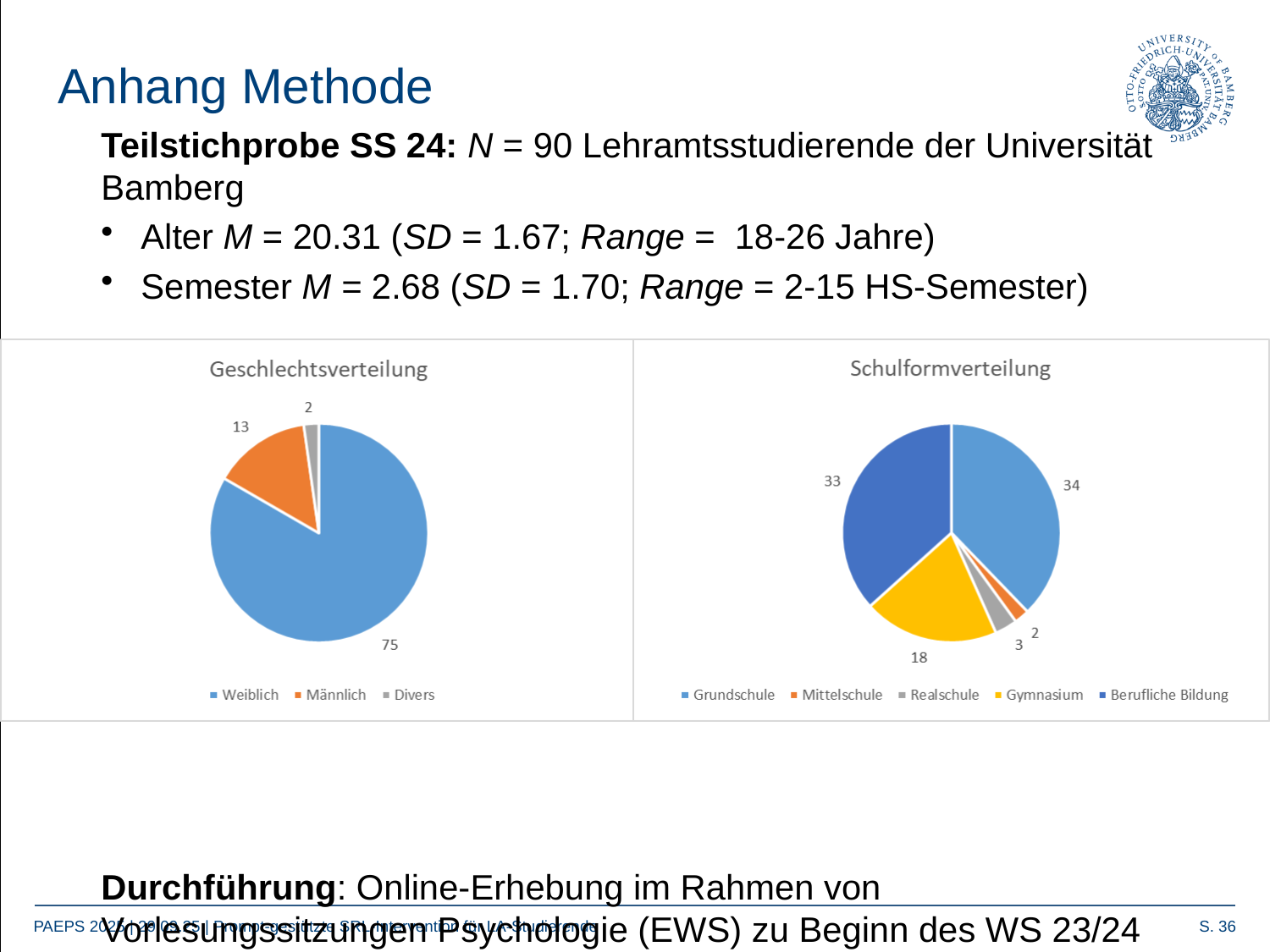
In the Geschlechtsverteilung chart, what is the value for Männlich? 13 In the Schulformverteilung chart, which category has the largest slice? Grundschule What kind of chart is the Schulformverteilung chart? Pie chart In the Schulformverteilung chart, what is the value for Gymnasium? 18 In the Schulformverteilung chart, what is the difference between Grundschule and Gymnasium? 16 In the Geschlechtsverteilung chart, what is the difference between Weiblich and Männlich? 62 In the Geschlechtsverteilung chart, which category has the smallest slice? Divers In the Schulformverteilung chart, which is larger, Realschule or Mittelschule? Realschule In the Schulformverteilung chart, how many categories does the legend list? 5 In the Geschlechtsverteilung chart, how many categories does the legend list? 3 In the Geschlechtsverteilung chart, what is the value for Weiblich? 75 In the Schulformverteilung chart, what is the value for Berufliche Bildung? 33